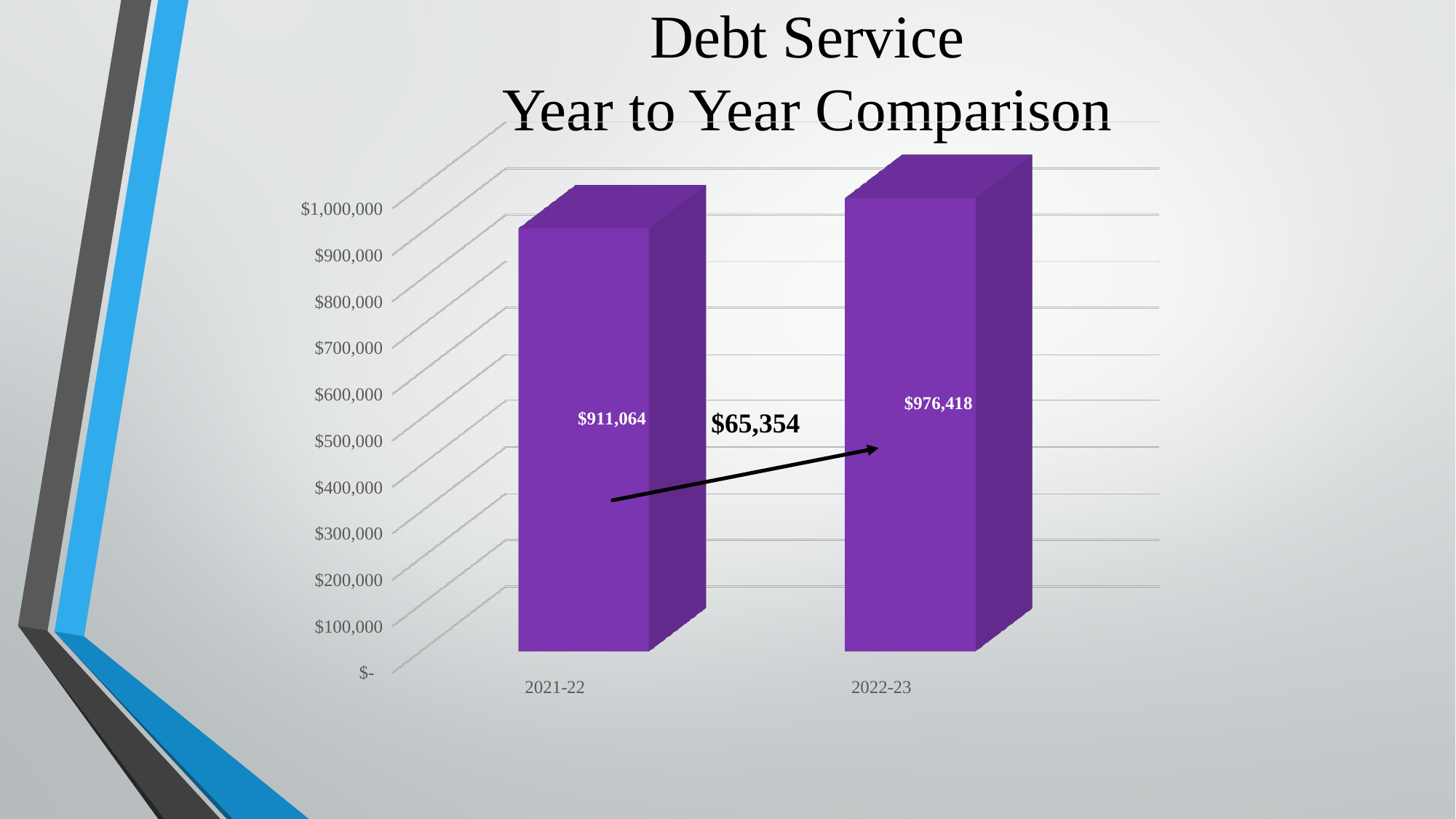
What is the debt service value for 2022-23? $976,418 Is the value for 2021-22 greater or less than $1,000,000? less What is the title of the chart? Debt Service Year to Year Comparison How many years are shown on the chart? 2 Which year has the higher debt service? 2022-23 Is the value for 2022-23 greater or less than $900,000? greater What kind of chart is shown on the slide? bar chart Is the debt service for 2022-23 larger or smaller than for 2021-22? larger Does the debt service rise or fall from 2021-22 to 2022-23? rise What is the debt service value for 2021-22? $911,064 Which year has the lower debt service? 2021-22 What is the difference between the 2022-23 and 2021-22 debt service values? $65,354